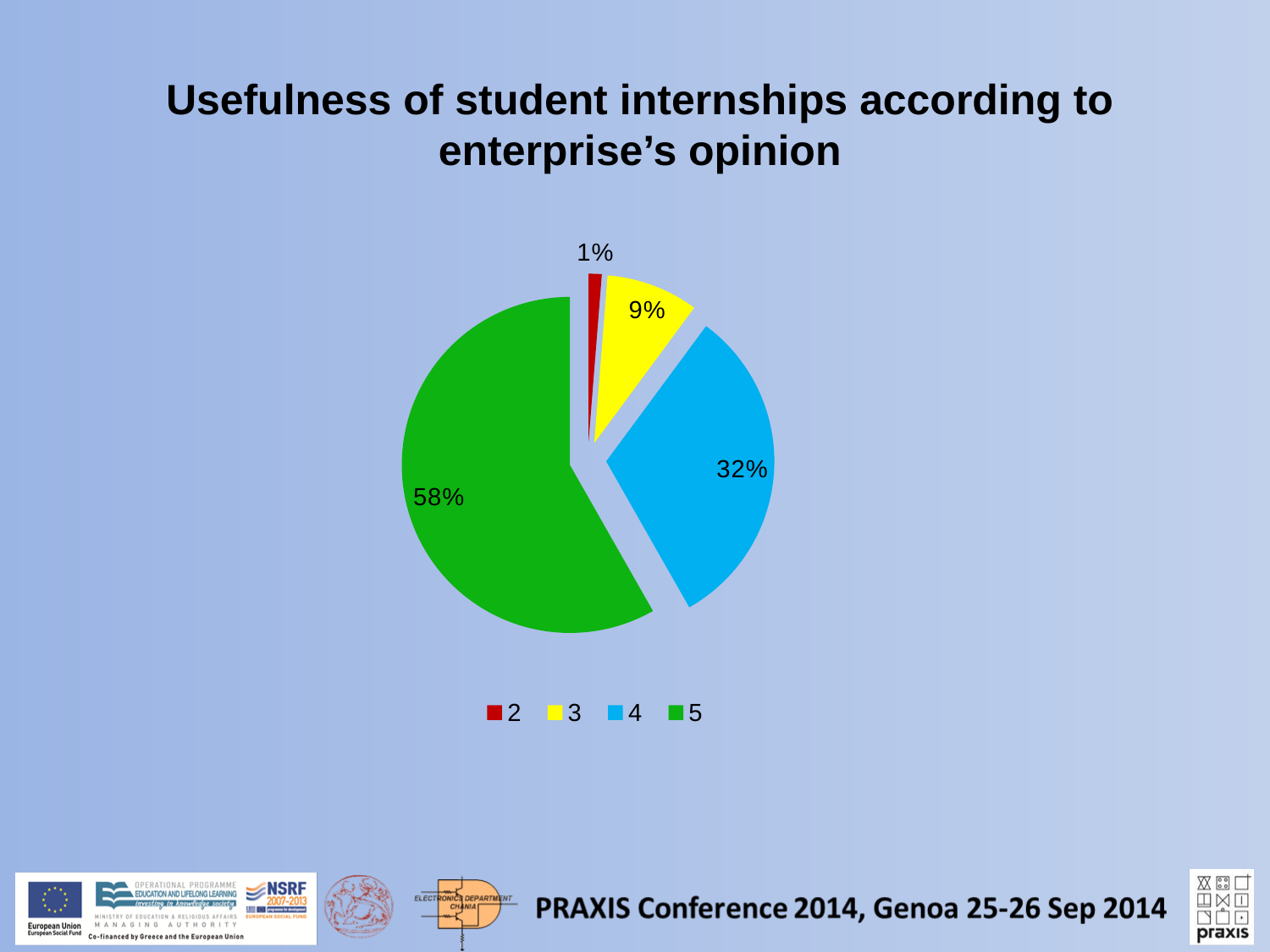
What share of the pie does category 3 have? 9% What share of the pie does category 5 have? 58% What share of the pie does category 2 have? 1% What is the title of the chart? Usefulness of student internships according to enterprise's opinion Which category has the smallest slice of the pie? 2 What is the difference in percentage points between the slices for category 5 and category 4? 26 What colour is the slice for category 3? yellow How many categories does the legend list? 4 What kind of chart is shown on the slide? pie chart Which category has the largest slice of the pie? 5 Which slice is larger, category 3 or category 4? 4